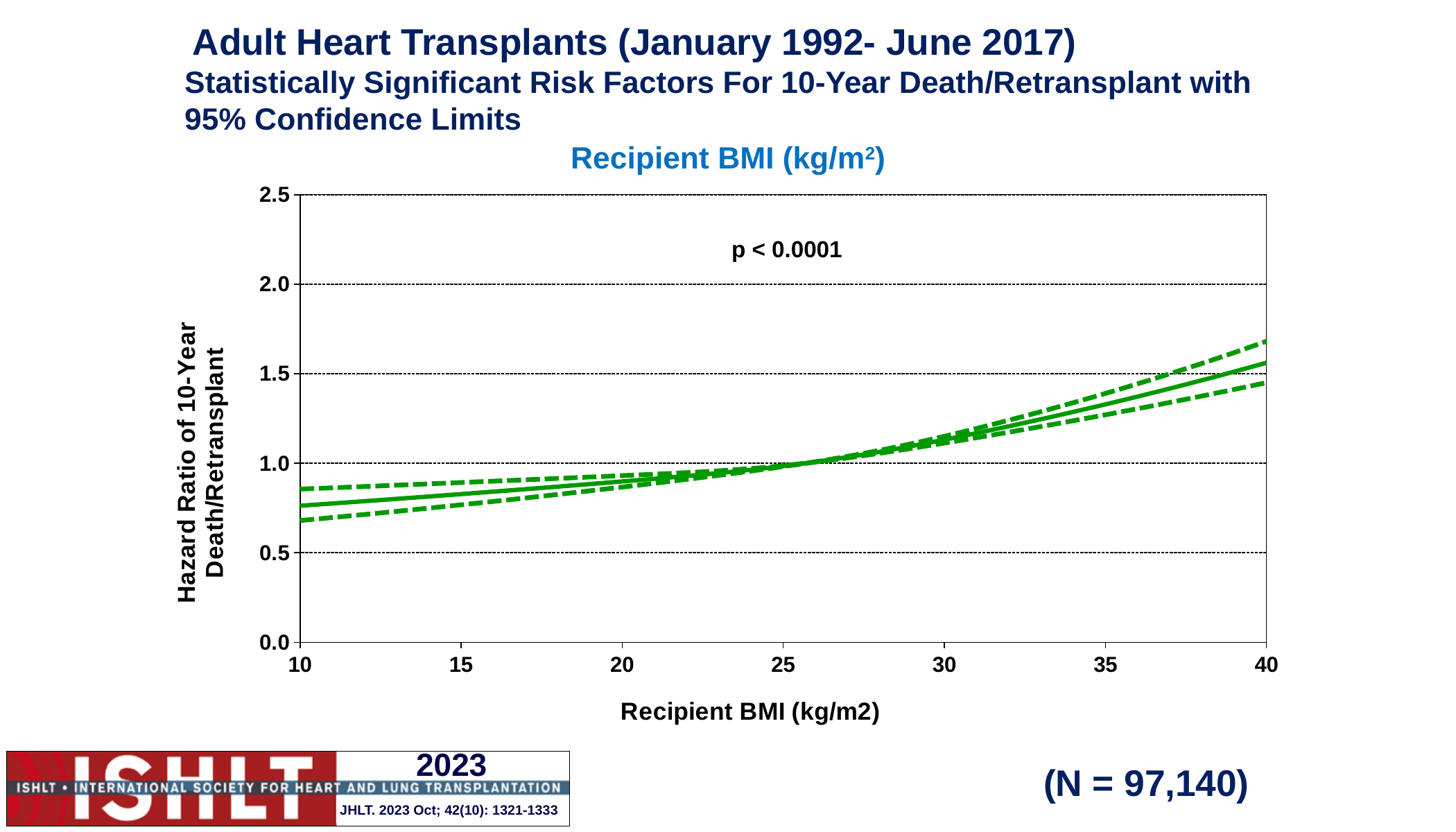
How many lines are plotted on the chart? 3 What kind of chart is shown on the slide? line chart Is the hazard ratio (solid line) at a recipient BMI of 40 greater or less than 1.0? greater What is the sample size (N) shown on the slide? 97,140 What p-value is printed on the chart? p < 0.0001 Does the hazard ratio of 10-year death/retransplant rise or fall as recipient BMI increases from 10 to 40? rise Is the upper 95% confidence limit (upper dashed line) at a recipient BMI of 40 greater or less than 1.5? greater Is the hazard ratio (solid line) at a recipient BMI of 10 greater or less than 1.0? less